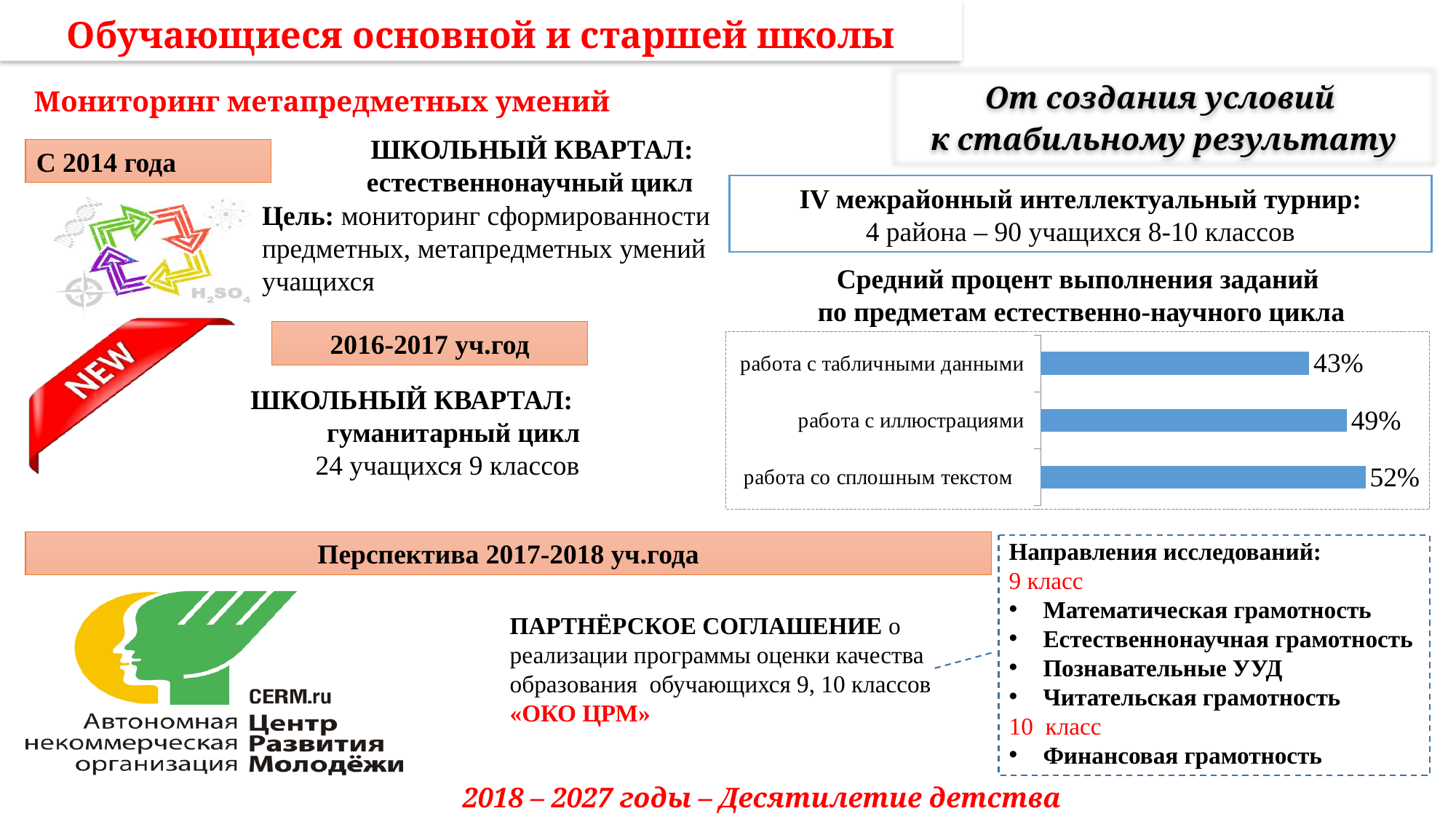
Which category has the lowest average percentage of task completion? работа с табличными данными What is the difference between the values for 'работа с иллюстрациями' and 'работа с табличными данными'? 6% Which is larger: the value for 'работа с иллюстрациями' or for 'работа с табличными данными'? работа с иллюстрациями Which category has the highest average percentage of task completion? работа со сплошным текстом What colour are the bars in the chart? blue What is the value shown for 'работа со сплошным текстом'? 52% What is the average percentage of task completion for 'работа с табличными данными'? 43% What type of chart is used to show the average percentage of task completion? bar chart How many categories are shown in the chart? 3 What is the title of the chart on the slide? Средний процент выполнения заданий по предметам естественно-научного цикла What is the value shown for 'работа с иллюстрациями'? 49% What is the difference between the values for 'работа со сплошным текстом' and 'работа с табличными данными'? 9%